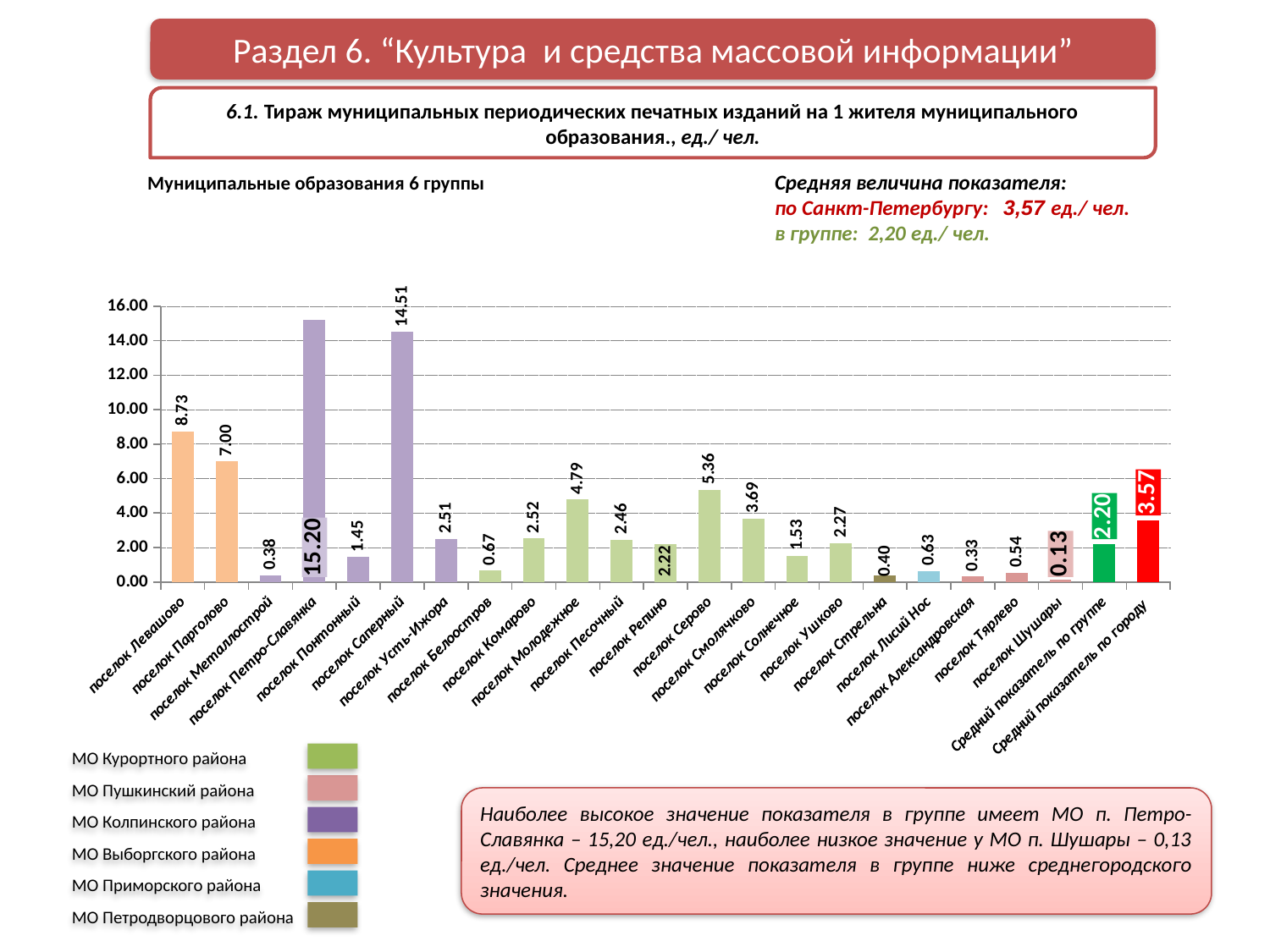
What is the value for поселок Петро-Славянка? 15.20 What is the value for поселок Саперный? 14.51 Which category has the lowest value on the chart? поселок Шушары Is the value for поселок Левашово greater or less than 8.00? greater What is the value for поселок Шушары? 0.13 Which is larger, the value for поселок Серово or the value for поселок Молодежное? поселок Серово What is the difference between the values for поселок Левашово and поселок Парголово? 1.73 What is the value shown for Средний показатель по городу? 3.57 How many bars are plotted on the chart? 23 What kind of chart is shown on the slide? bar chart What is the difference between Средний показатель по городу and Средний показатель по группе? 1.37 Which category has the highest value on the chart? поселок Петро-Славянка